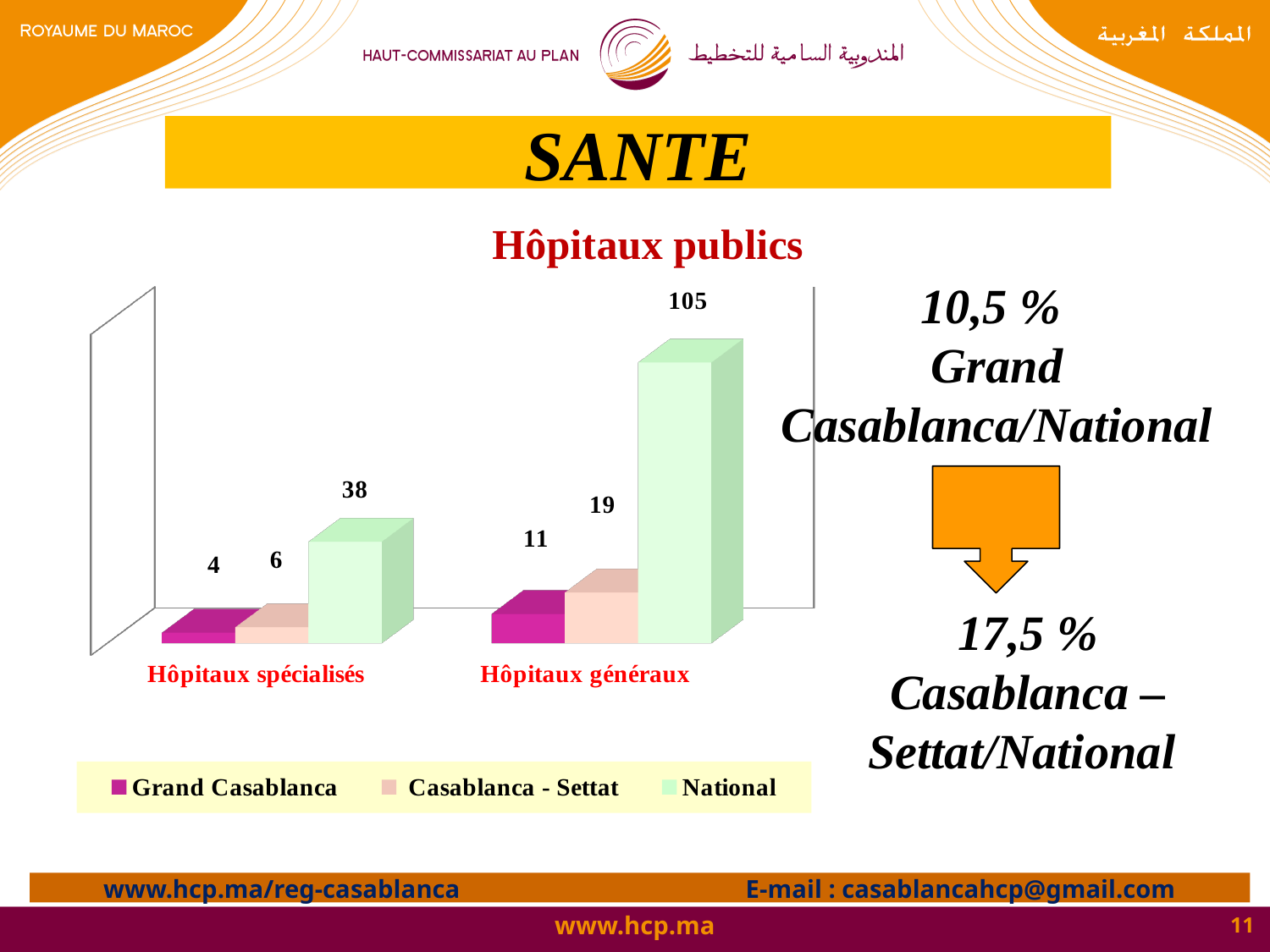
What is the value for National in the Hôpitaux généraux category? 105 What is the value for Casablanca - Settat in the Hôpitaux généraux category? 19 Which series has the lowest value in the Hôpitaux spécialisés category? Grand Casablanca What is the difference between the Casablanca - Settat and Grand Casablanca values for Hôpitaux généraux? 8 What kind of chart is shown on the slide? Bar chart What is the value for National in the Hôpitaux spécialisés category? 38 How many series does the legend list? 3 What is the value for Grand Casablanca in the Hôpitaux spécialisés category? 4 How many categories are shown on the x axis of the chart? 2 What is the difference between the National values for Hôpitaux généraux and Hôpitaux spécialisés? 67 Which is larger: the Grand Casablanca value for Hôpitaux généraux or the Casablanca - Settat value for Hôpitaux spécialisés? Grand Casablanca value for Hôpitaux généraux Which series has the highest value in the Hôpitaux généraux category? National